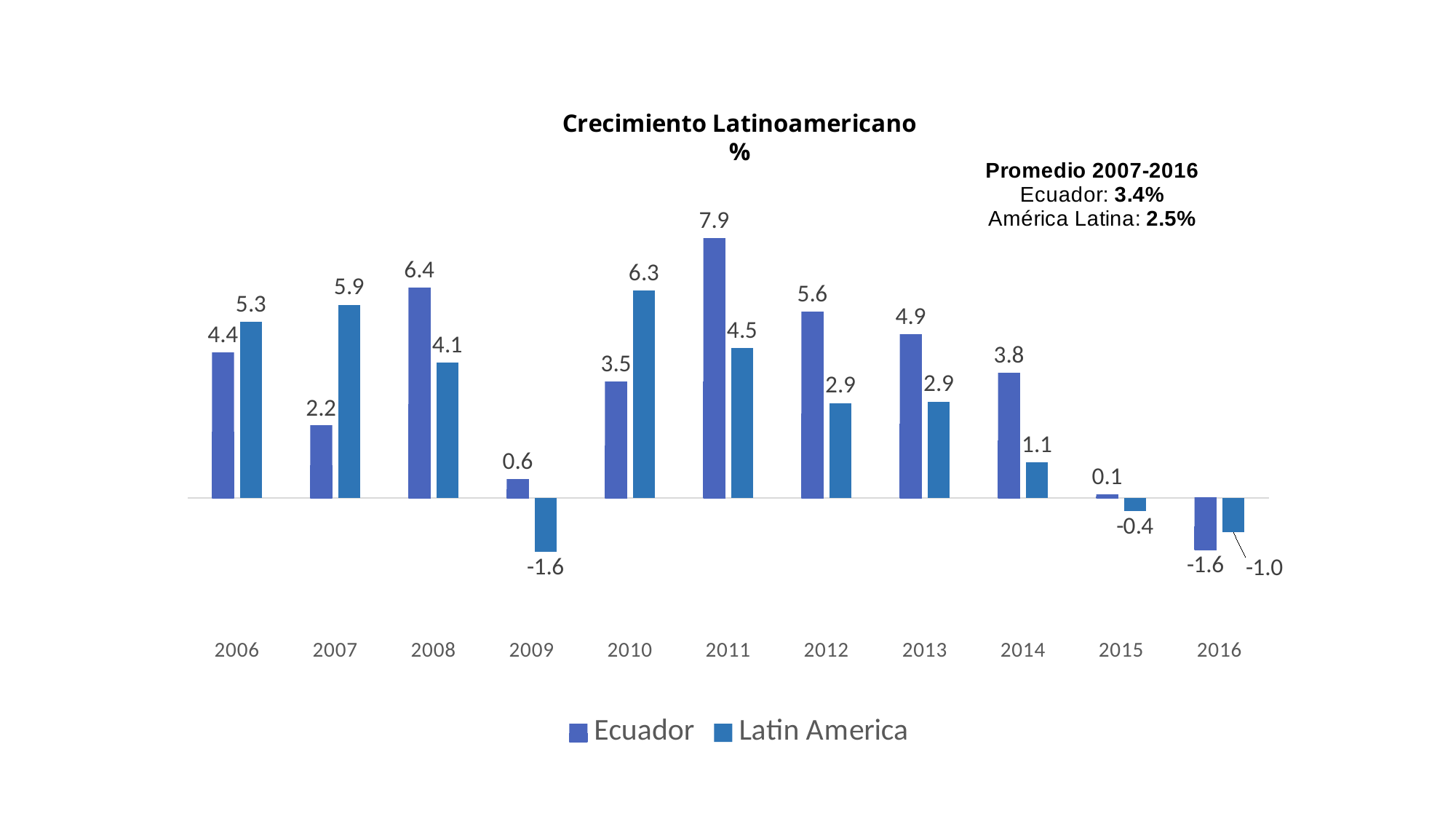
Which is larger in 2007, the Ecuador value or the Latin America value? Latin America What is the value for Ecuador in 2011? 7.9 What is the value for Ecuador in 2015? 0.1 How many years are shown on the x axis? 11 In which year is the Latin America value lowest? 2009 What is the difference between the Ecuador and Latin America values in 2008? 2.3 What is the title of the chart? Crecimiento Latinoamericano % What kind of chart is shown? Bar chart What is the value for Latin America in 2009? -1.6 How many series does the legend list? 2 In which year is the Ecuador value highest? 2011 Do the Ecuador values rise or fall from 2011 to 2016? Fall